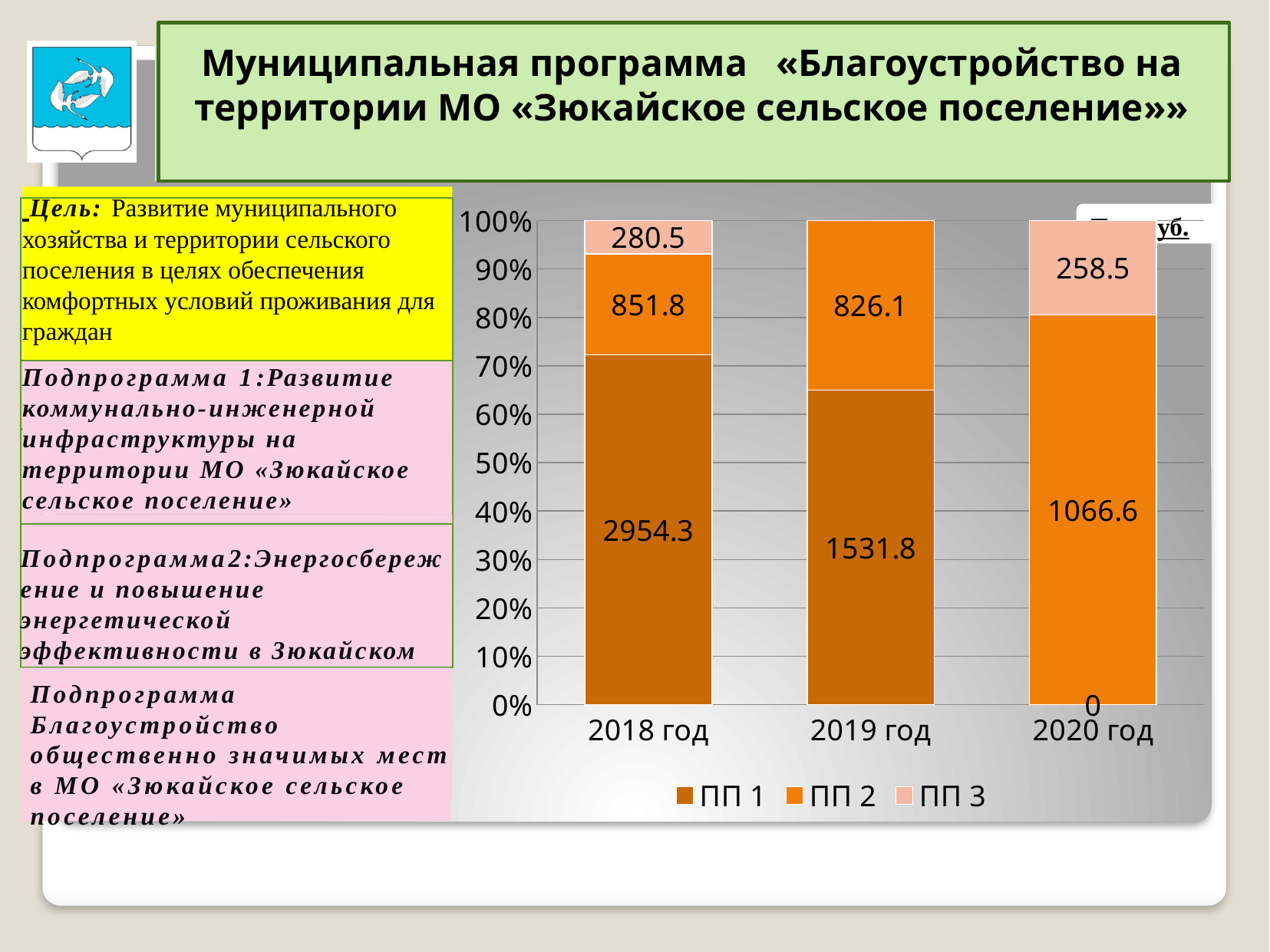
How many year categories are shown on the x axis of the chart? 3 What is the value of ПП 1 for 2018 год? 2954.3 What is the difference between the ПП 2 values for 2018 год and 2019 год? 25.7 Do the ПП 1 values rise or fall from 2018 год to 2020 год? Fall What is the value of ПП 2 for 2019 год? 826.1 What is the total of the three segments in the 2018 год bar? 4086.6 Which year has the larger ПП 3 value, 2018 год or 2020 год? 2018 год What is the value of ПП 1 for 2020 год? 0 In which year is the value of ПП 1 the highest? 2018 год What is the value of ПП 3 for 2020 год? 258.5 What kind of chart is shown on the slide? Stacked bar chart How many series does the chart legend list? 3